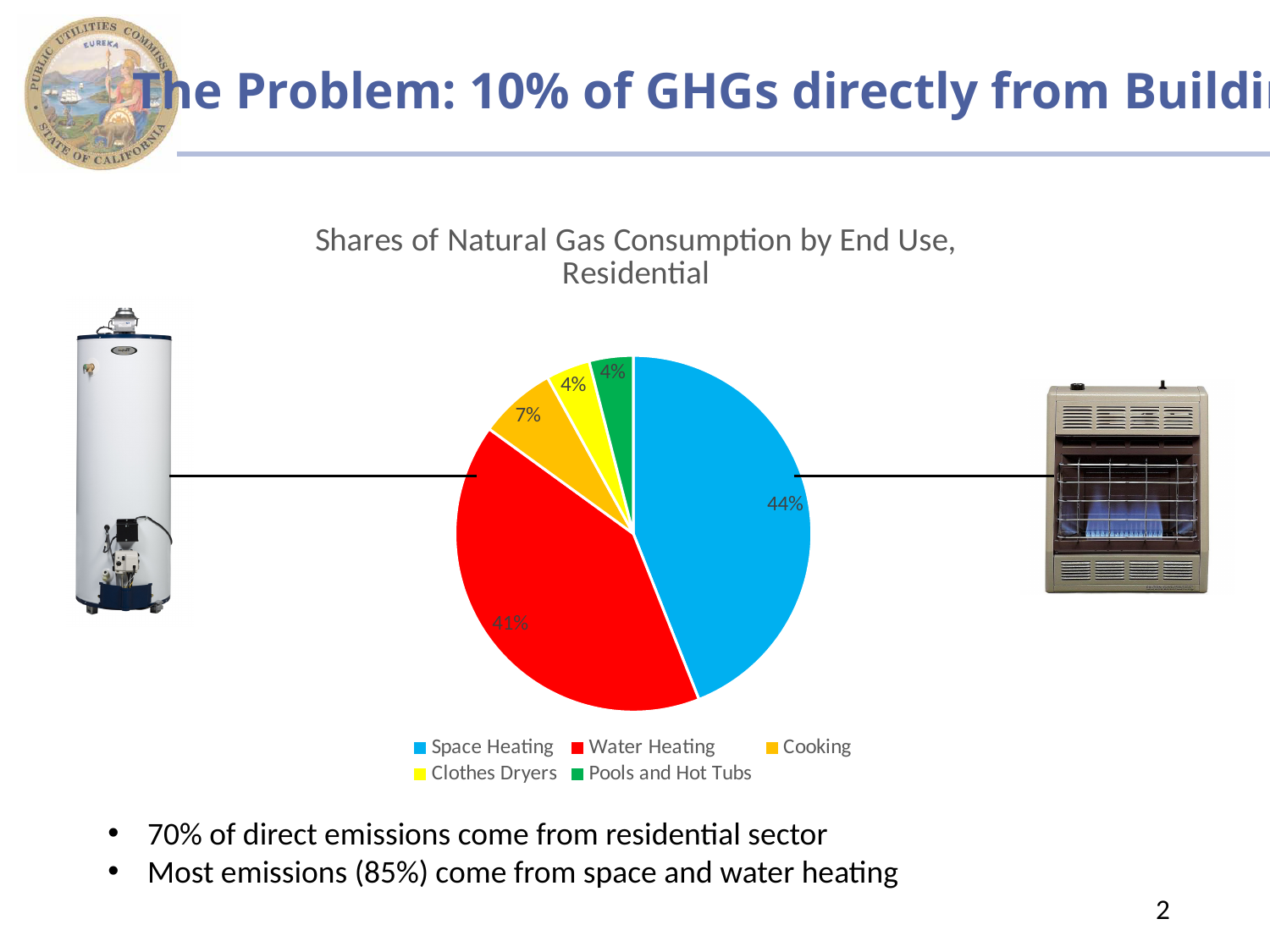
Which has a larger share, Space Heating or Water Heating? Space Heating What kind of chart is shown on the slide? pie chart What share of residential natural gas consumption is Cooking? 7% What share of residential natural gas consumption is Space Heating? 44% What is the difference in share between Space Heating and Water Heating? 3% What share of residential natural gas consumption is Water Heating? 41% Which end use has the largest share of residential natural gas consumption? Space Heating How many end-use categories does the pie chart show? 5 What is the title of the chart? Shares of Natural Gas Consumption by End Use, Residential What colour is the Cooking slice in the pie chart? orange